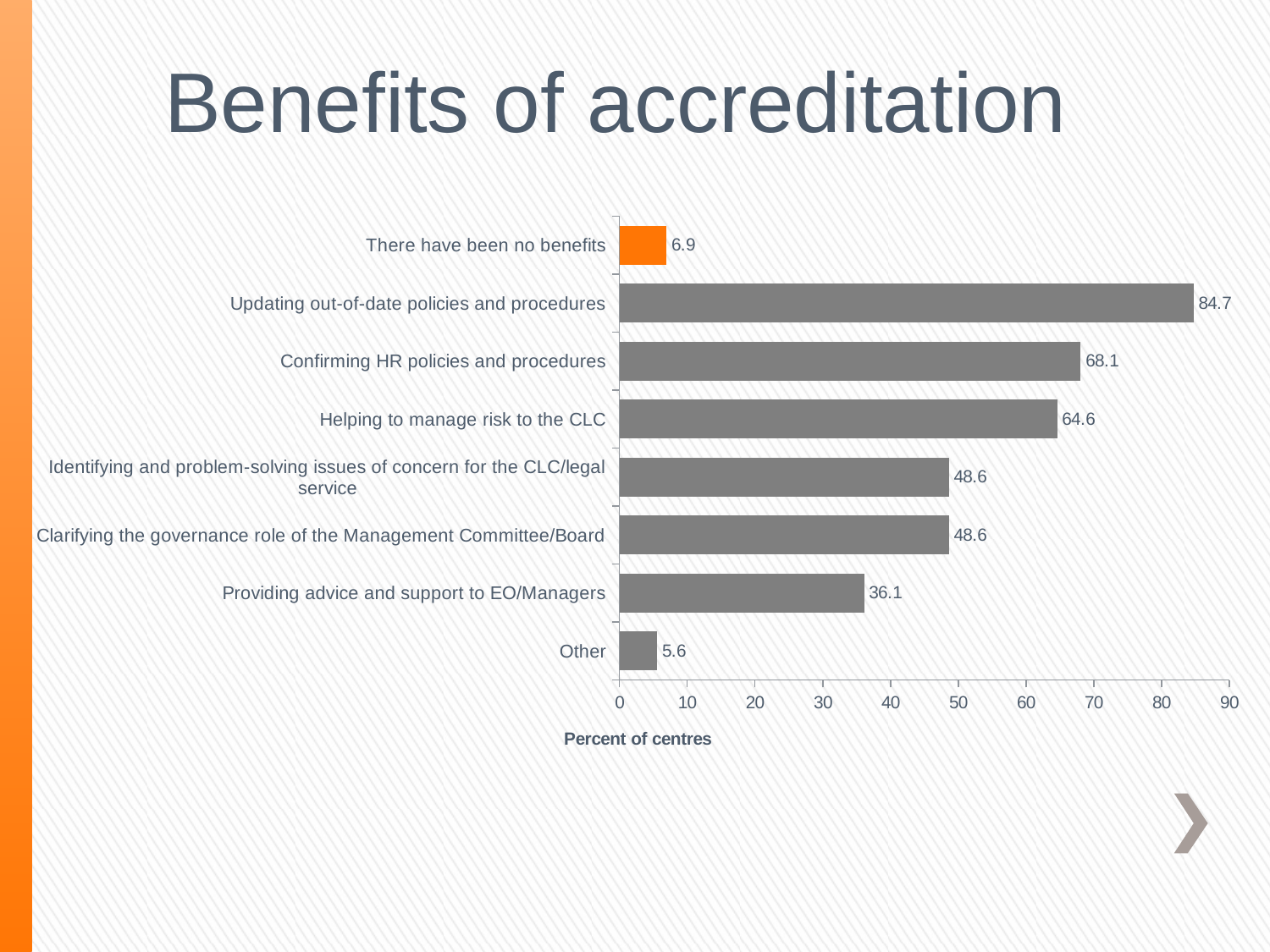
Is the value for "Providing advice and support to EO/Managers" greater or less than 40? less Which category has the lowest value? Other What is the value for "There have been no benefits"? 6.9 Which category has the highest value? Updating out-of-date policies and procedures What is the label of the horizontal axis? Percent of centres Which is larger: the value for "Confirming HR policies and procedures" or the value for "Helping to manage risk to the CLC"? Confirming HR policies and procedures What is the difference between the values for "Updating out-of-date policies and procedures" and "Confirming HR policies and procedures"? 16.6 What is the value for "Helping to manage risk to the CLC"? 64.6 What is the value for "Providing advice and support to EO/Managers"? 36.1 How many categories are shown in the chart? 8 What kind of chart is shown on the slide? Bar chart What is the value for "Updating out-of-date policies and procedures"? 84.7